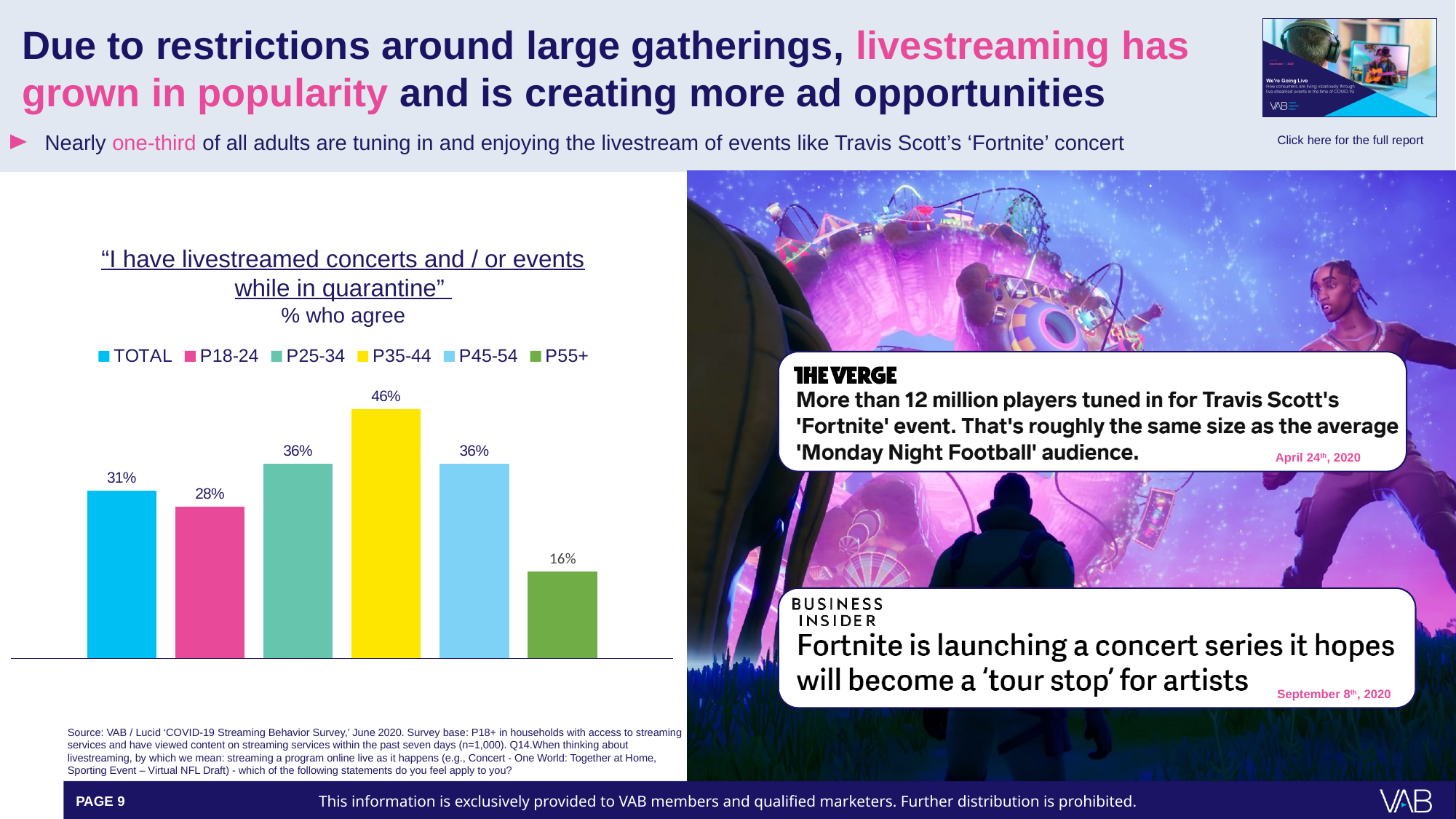
How many series does the legend list? 6 What is the difference between the TOTAL value and the P18-24 value? 3% Which group has the highest percentage who agree? P35-44 Which is larger, the value for P25-34 or the value for P18-24? P25-34 What kind of chart is shown on the slide? Bar chart How many bars are plotted in the chart? 6 What is the value shown for P18-24? 28% What is the difference between the P35-44 value and the P55+ value? 30% What colour is the bar for P35-44? Yellow Which group has the lowest percentage who agree? P55+ What is the value shown for P55+? 16% What percentage of the TOTAL group agree they have livestreamed concerts and/or events while in quarantine? 31%